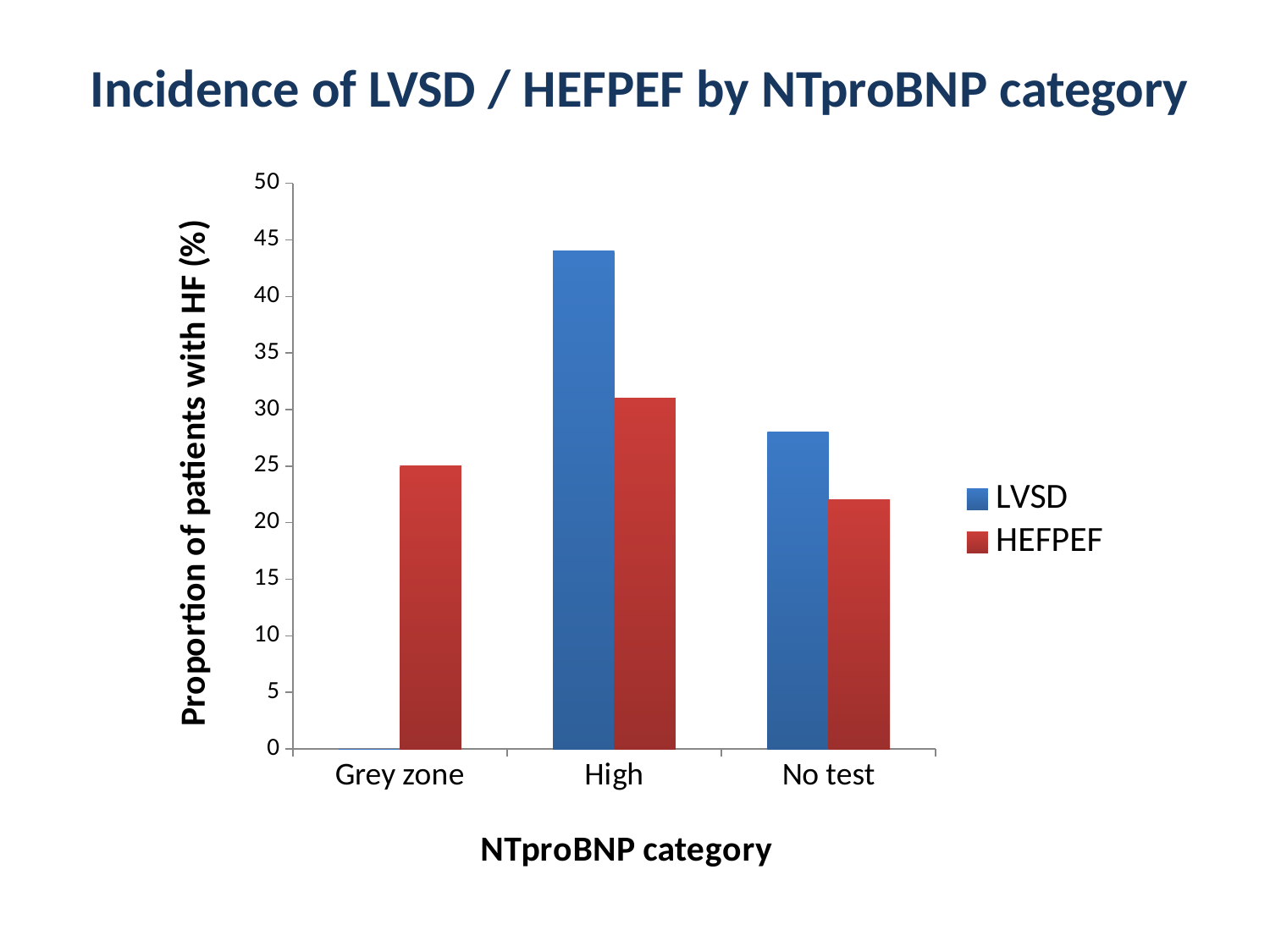
What is the HEFPEF value for the Grey zone category? 25 In the High category, which is larger, LVSD or HEFPEF? LVSD Which NTproBNP category has the highest LVSD value? High Is the LVSD value for the High category greater or less than 40? greater Which NTproBNP category has the highest HEFPEF value? High Is the LVSD value for the No test category greater or less than 25? greater What is the label of the y axis? Proportion of patients with HF (%) How many series does the legend list? 2 Is the HEFPEF value for the No test category greater or less than 25? less Which NTproBNP category has the lowest HEFPEF value? No test What type of chart is shown on the slide? bar chart How many NTproBNP categories are shown on the x axis? 3